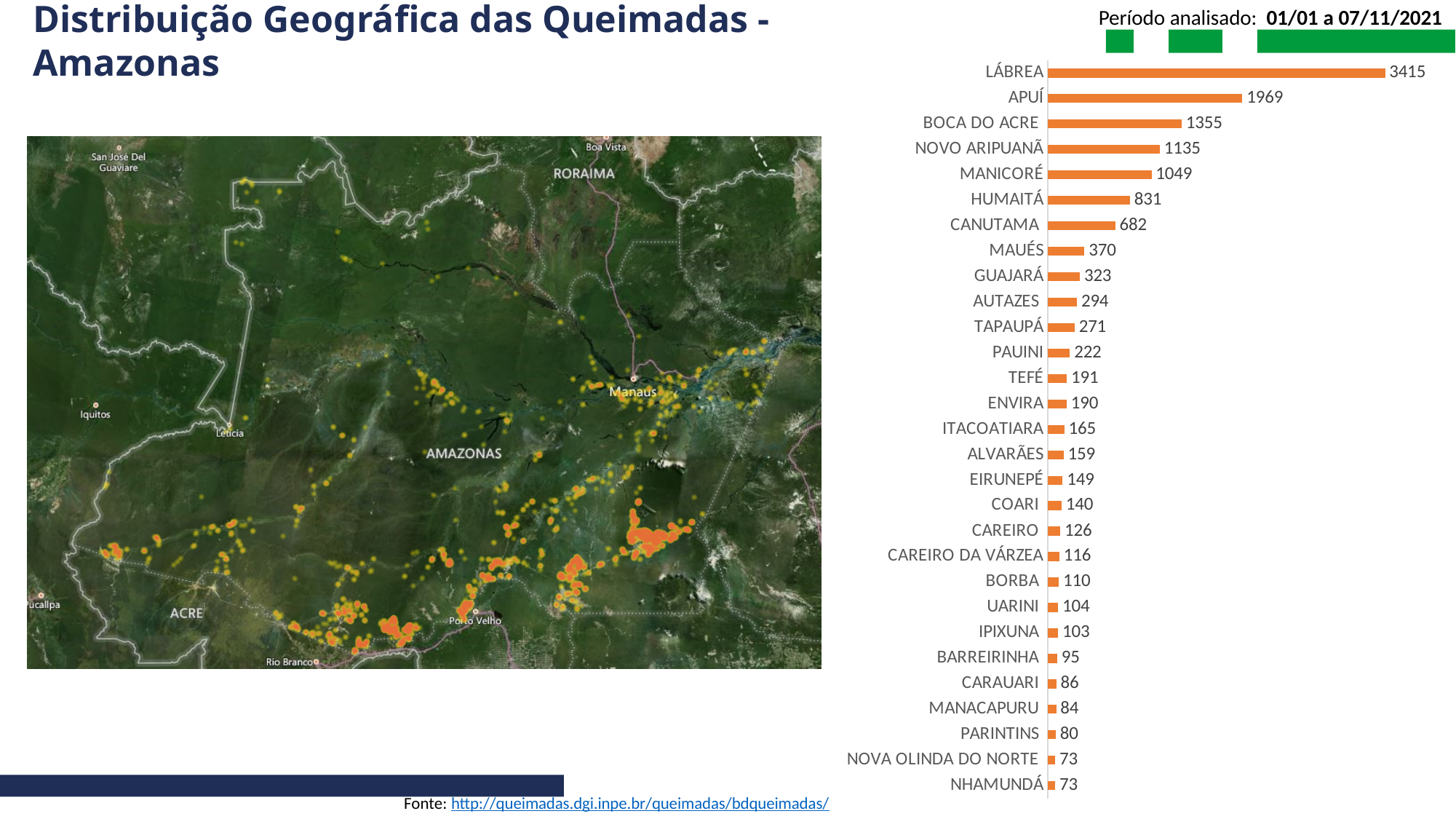
What is the value for HUMAITÁ? 831 What is the value for LÁBREA? 3415 What type of chart is shown on the slide? bar chart What period is analysed according to the text above the chart? 01/01 a 07/11/2021 What is the difference between the values for MANICORÉ and CANUTAMA? 367 Which municipality has the highest value? LÁBREA Which has a larger value, MAUÉS or GUAJARÁ? MAUÉS What is the value for TEFÉ? 191 What is the value for PARINTINS? 80 What is the difference between the values for LÁBREA and APUÍ? 1446 What is the value for BOCA DO ACRE? 1355 How many municipalities are listed in the chart? 29